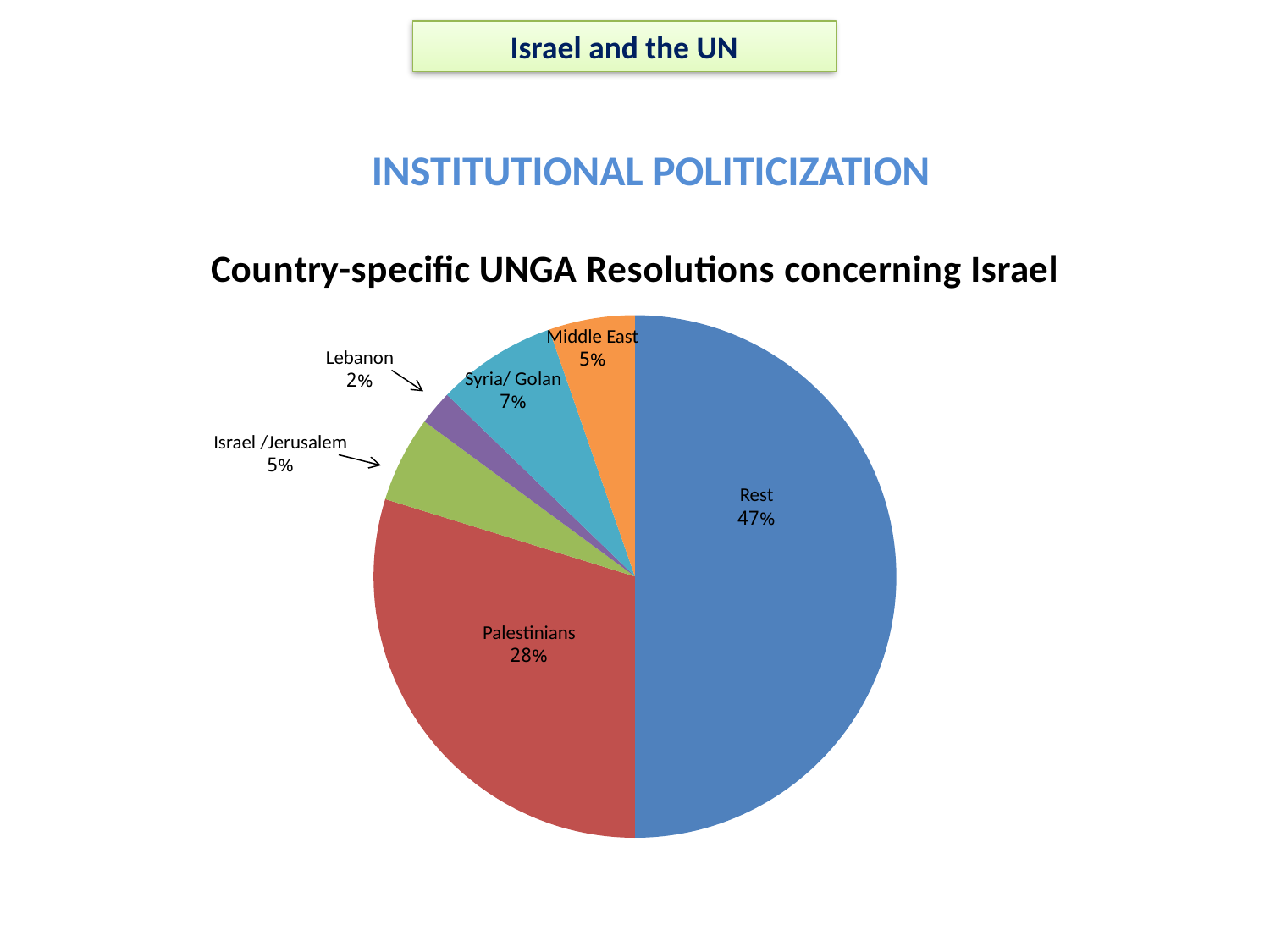
What kind of chart is shown on the slide? pie chart What share of the pie is labelled Syria/ Golan? 7% Which slice of the pie is the largest? Rest What share of the pie is labelled Palestinians? 28% What share of the pie is labelled Lebanon? 2% Which slice of the pie is the smallest? Lebanon What is the title of the chart? Country-specific UNGA Resolutions concerning Israel How many slices does the pie chart have? 6 Which is larger, the Syria/ Golan slice or the Middle East slice? Syria/ Golan What is the difference between the Rest share and the Palestinians share? 19%